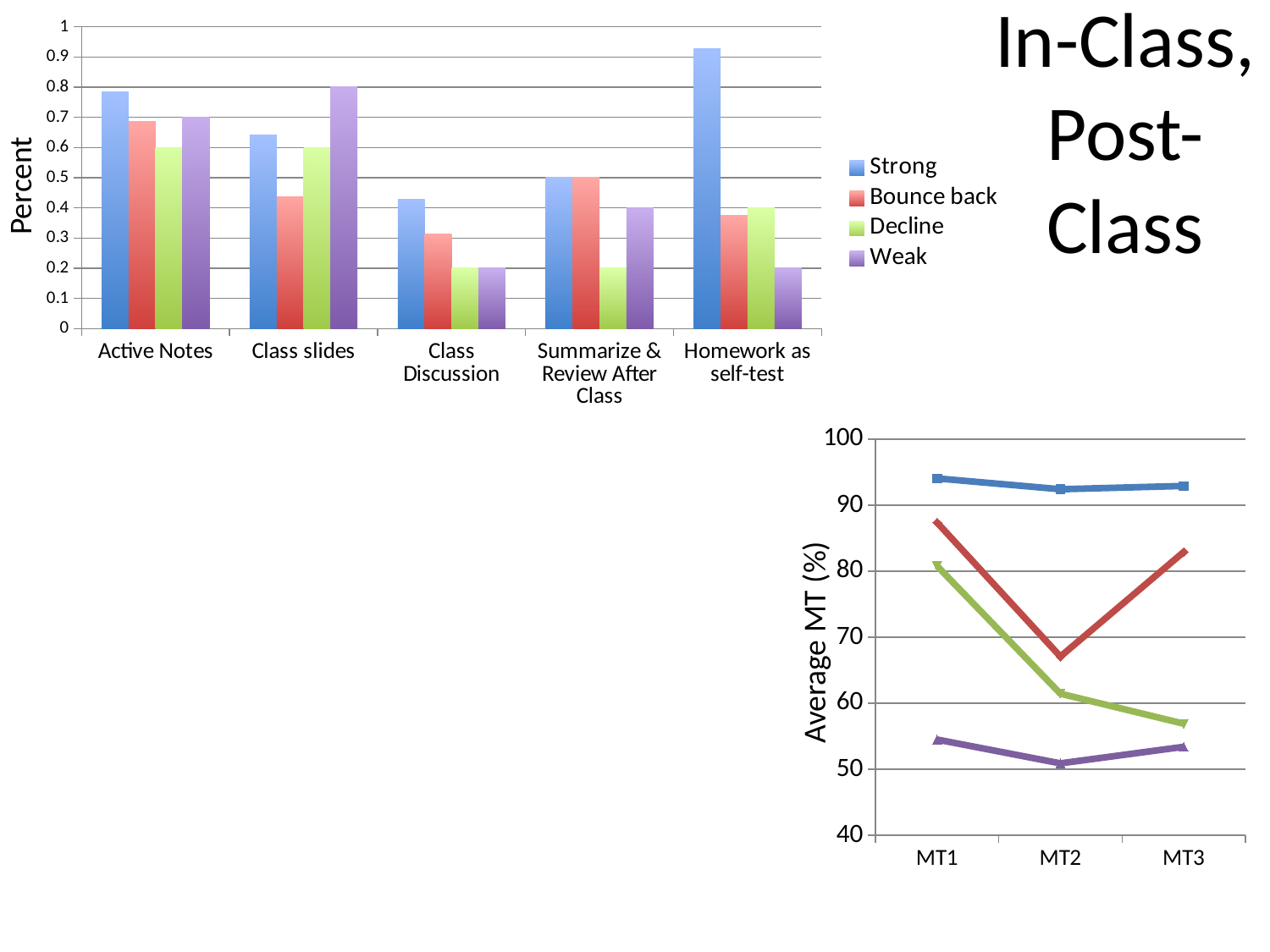
In the bottom-right line chart, is the value of the red line at MT2 greater or less than 70? less What is the y-axis label of the top-left bar chart? Percent In the top-left bar chart, how many series does the legend list? 4 What kind of chart is the bottom-right chart on the slide? line chart In the top-left bar chart, which category has the highest value for the Weak series? Class slides In the top-left bar chart, is the Strong value for Homework as self-test greater or less than 0.9? greater In the top-left bar chart, which category has the highest value for the Strong series? Homework as self-test In the bottom-right line chart, how many points are shown on the x axis? 3 What kind of chart is the top-left chart on the slide? bar chart In the top-left bar chart, how many categories are shown on the x axis? 5 In the top-left bar chart, is the Bounce back value for Class Discussion greater or less than 0.4? less In the top-left bar chart, for Class slides, which is larger: the Strong value or the Bounce back value? Strong